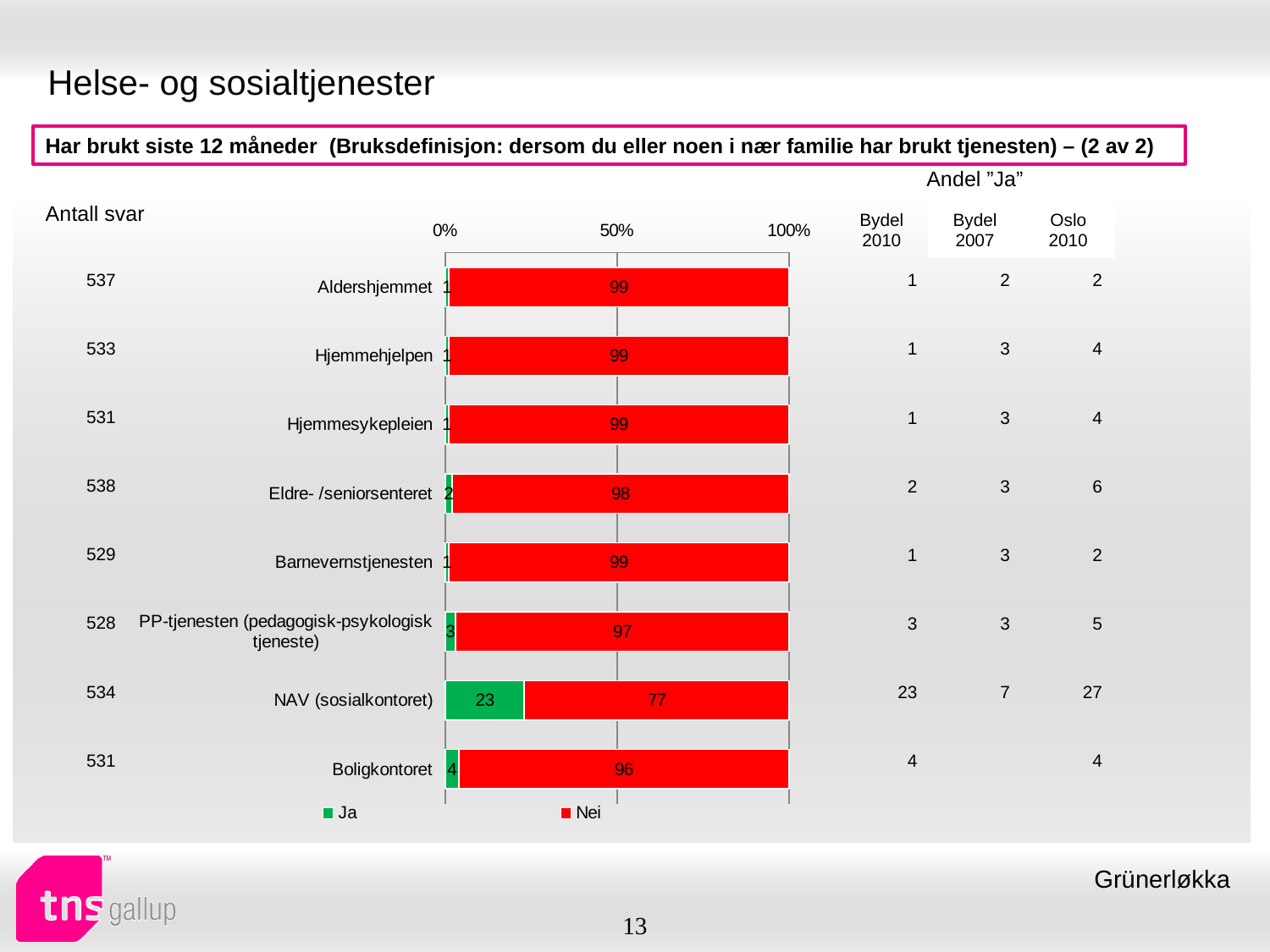
How many series does the chart legend list? 2 What is the difference between the 'Nei' values for Aldershjemmet and NAV (sosialkontoret)? 22 How many categories are plotted in the chart? 8 What is the 'Nei' value for Boligkontoret? 96 What kind of chart is shown on the slide? stacked bar chart Which category has the highest 'Ja' value? NAV (sosialkontoret) Which category has the lowest 'Nei' value? NAV (sosialkontoret) Which series is shown in red in the chart? Nei What is the 'Ja' value for NAV (sosialkontoret)? 23 What is the 'Nei' value for NAV (sosialkontoret)? 77 What is the 'Nei' value for PP-tjenesten (pedagogisk-psykologisk tjeneste)? 97 Is the 'Nei' value for NAV (sosialkontoret) larger or smaller than the 'Nei' value for Eldre- /seniorsenteret? smaller